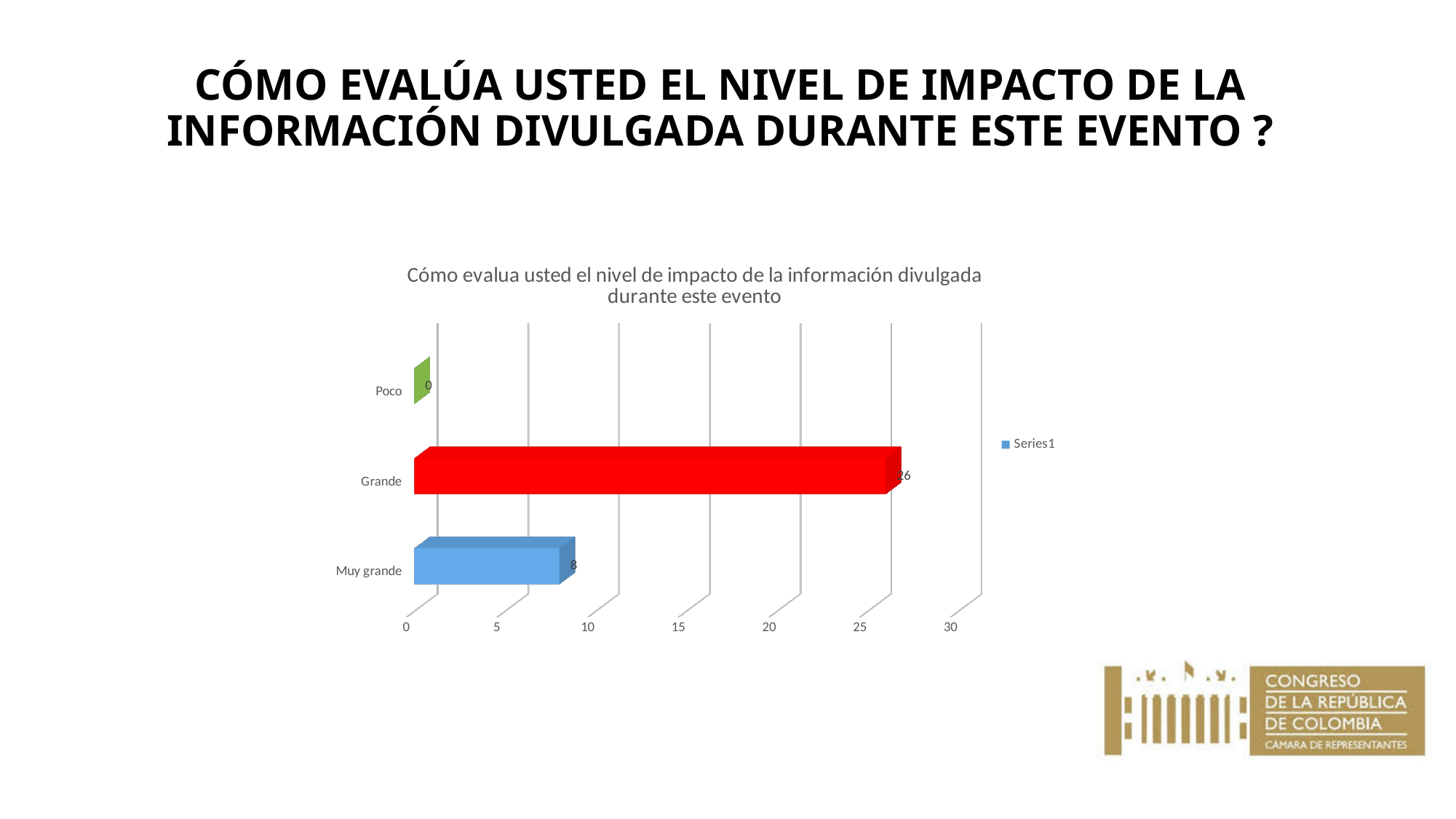
Is the value for Grande greater or less than 25? greater What is the value for Muy grande? 8 What colour is the bar for Grande? Red Which category has the highest value? Grande What kind of chart is shown on the slide? Bar chart How many series does the legend list? 1 Which is larger, the value for Grande or the value for Muy grande? Grande What is the value for Poco? 0 What is the difference between the values for Grande and Muy grande? 18 Which category has the lowest value? Poco What is the value for Grande? 26 How many categories are shown in the chart? 3